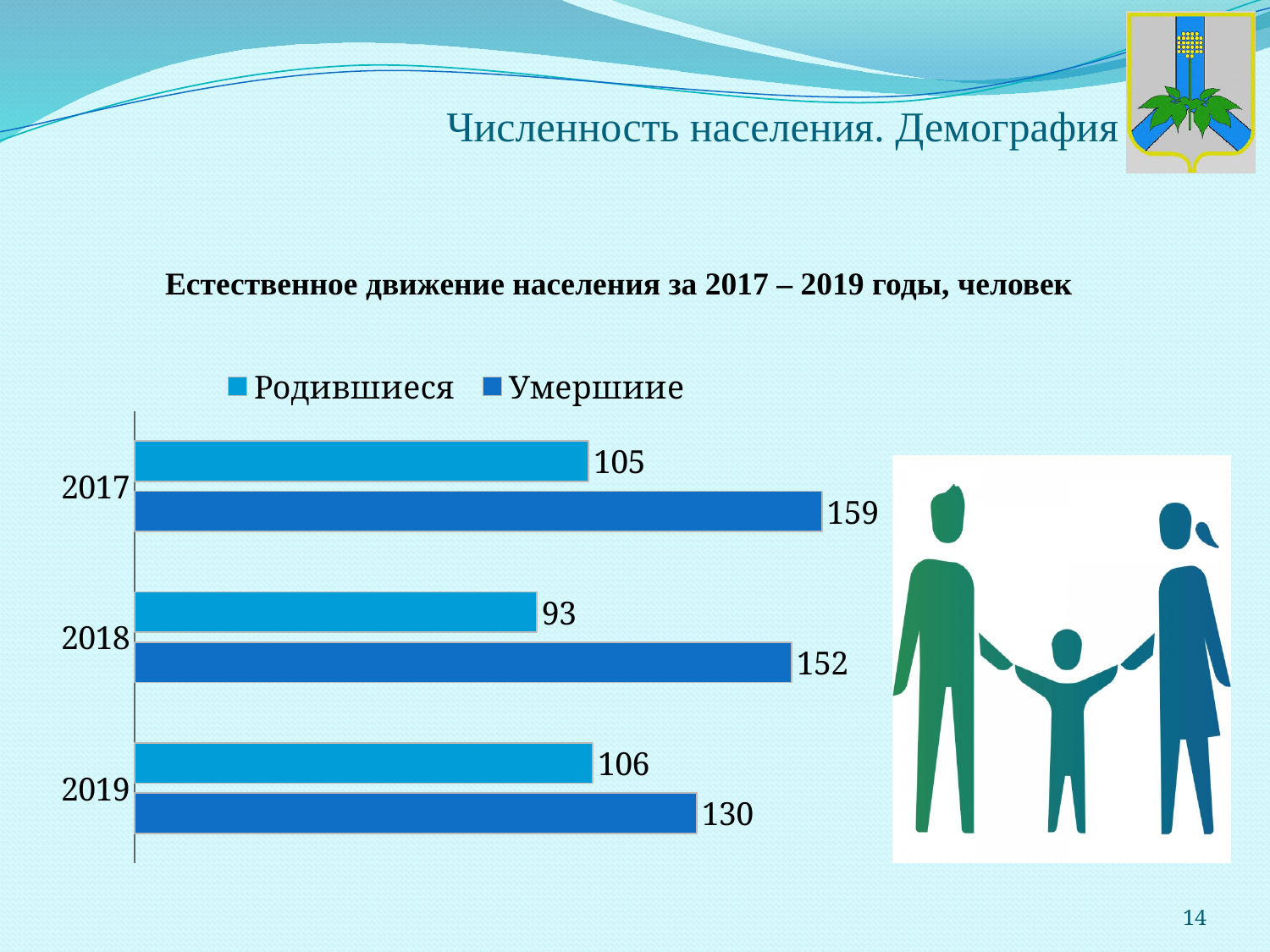
What is the difference between the Умершиие values for 2018 and 2019? 22 How many series does the legend list? 2 What is the value for Родившиеся in 2019? 106 How many years are shown on the chart? 3 What is the title of the chart? Естественное движение населения за 2017 – 2019 годы, человек What is the value for Родившиеся in 2017? 105 In which year is the Родившиеся value lowest? 2018 Which is larger in 2019, Родившиеся or Умершиие? Умершиие What is the value for Умершиие in 2018? 152 In which year is the Умершиие value highest? 2017 What kind of chart is shown on the slide? Bar chart What is the difference between Умершиие and Родившиеся in 2017? 54